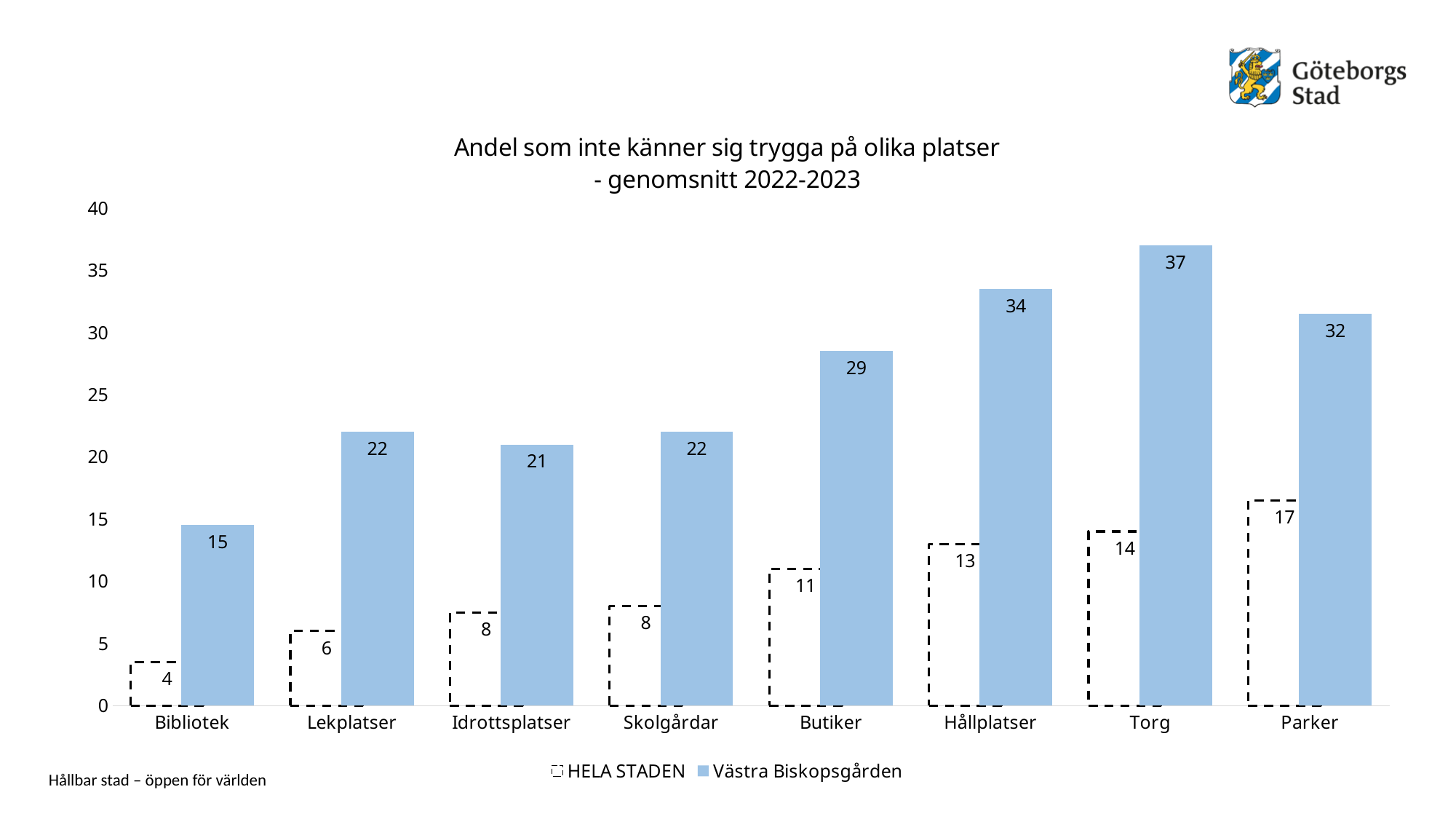
Which category has the highest value for Västra Biskopsgården? Torg Is the value for Västra Biskopsgården at Skolgårdar greater or less than 20? greater What is the value for HELA STADEN at Parker? 17 Which category has the lowest value for HELA STADEN? Bibliotek What kind of chart is shown? Bar chart What is the title of the chart? Andel som inte känner sig trygga på olika platser - genomsnitt 2022-2023 How many categories are shown on the x axis? 8 What is the difference between Västra Biskopsgården and HELA STADEN at Hållplatser? 21 Which is larger: the Västra Biskopsgården value at Butiker or at Parker? Parker What is the value for HELA STADEN at Bibliotek? 4 How many series does the legend list? 2 What is the value for Västra Biskopsgården at Torg? 37